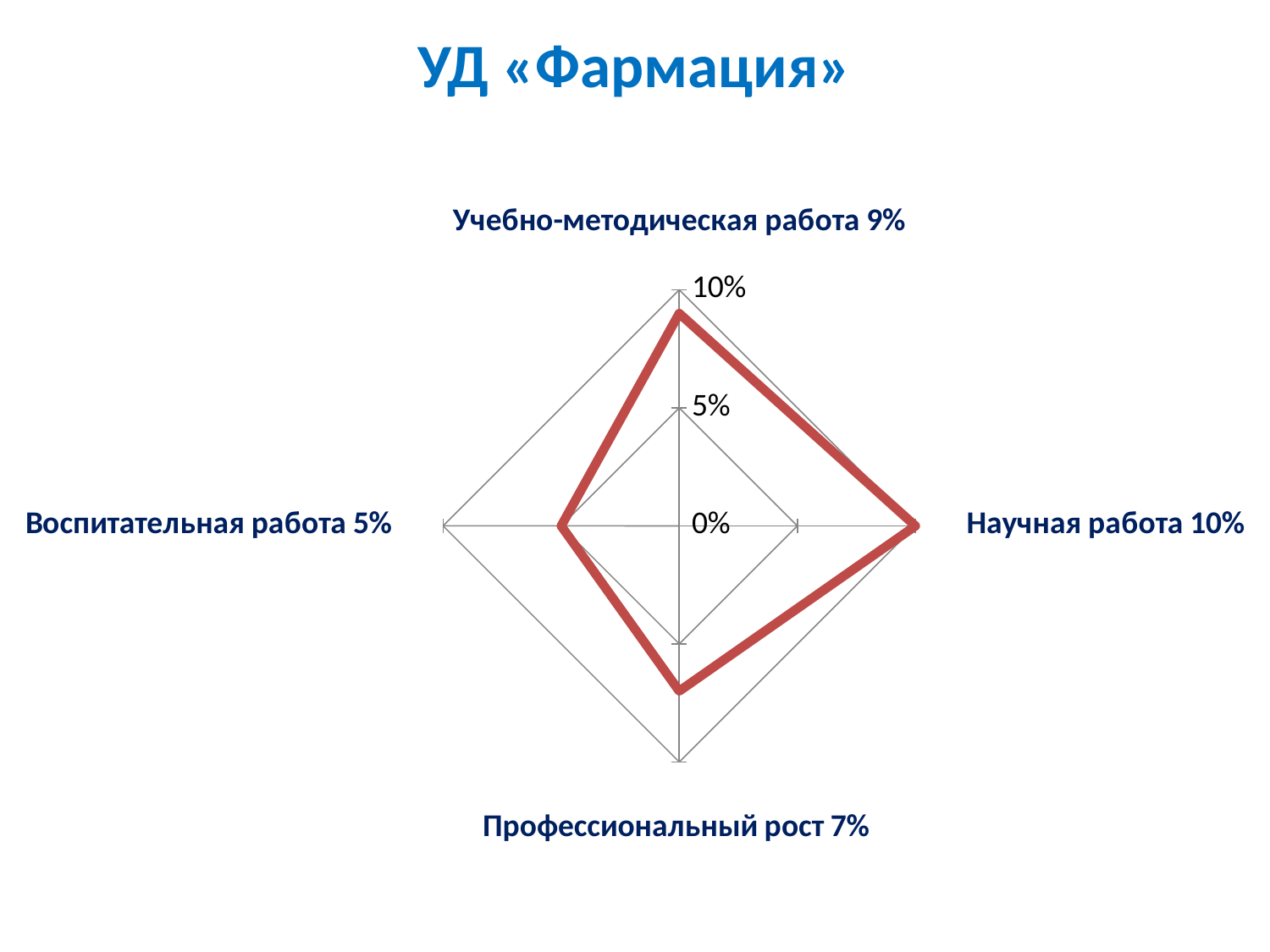
What is the value for Научная работа? 10% What type of chart is shown on the slide? Radar chart What is the value for Воспитательная работа? 5% Which is larger, the value for Профессиональный рост or the value for Воспитательная работа? Профессиональный рост What is the difference between the values for Научная работа and Воспитательная работа? 5% What is the title of the slide? УД «Фармация» Which category has the highest value? Научная работа How many categories (axes) does the radar chart have? 4 What is the difference between the values for Учебно-методическая работа and Профессиональный рост? 2% What is the value for Профессиональный рост? 7% Which category has the lowest value? Воспитательная работа What is the value for Учебно-методическая работа? 9%